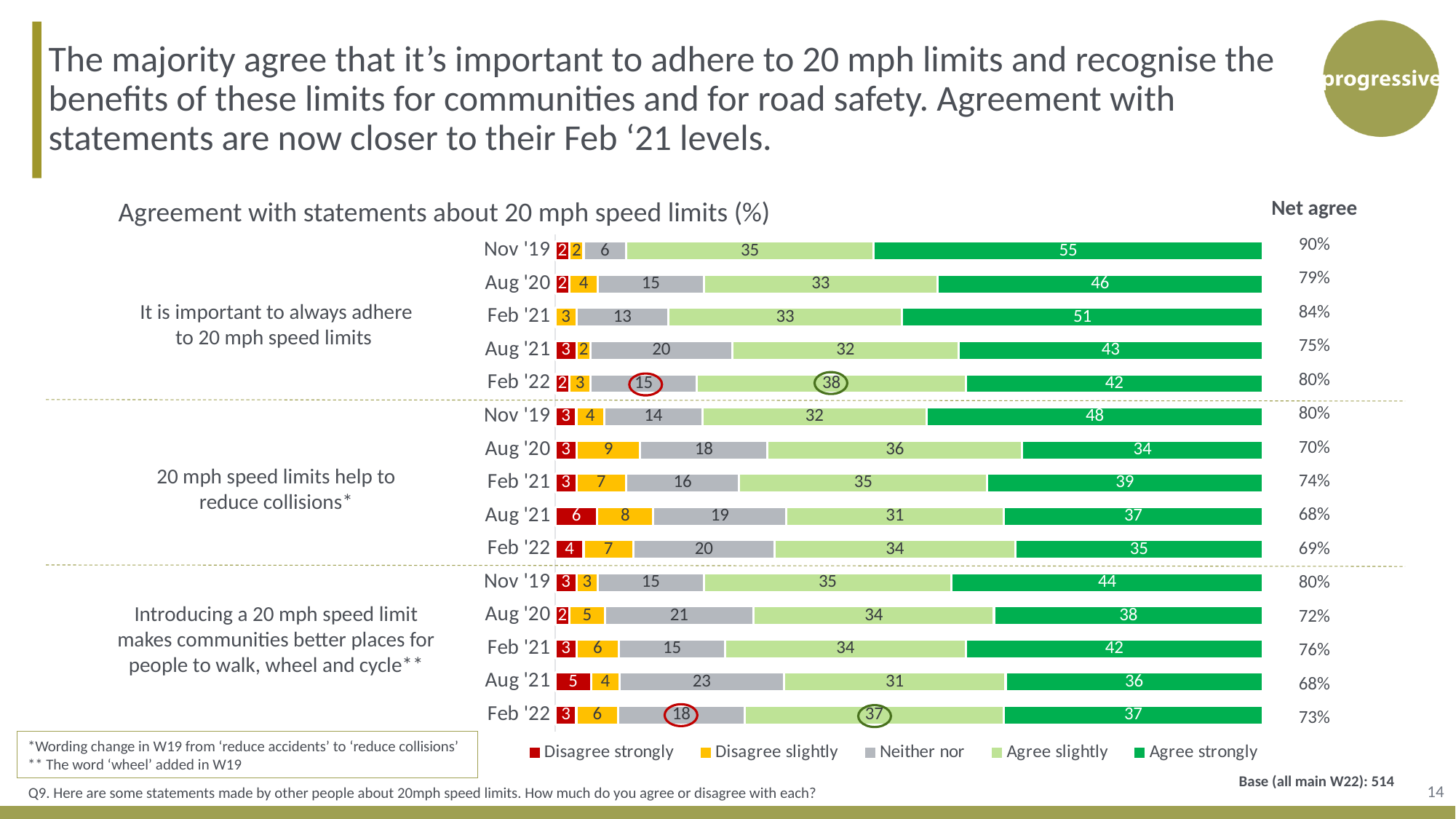
For '20 mph speed limits help to reduce collisions' in Aug '21, what is the combined total of 'Disagree strongly' and 'Disagree slightly'? 14 What is the net agree figure for '20 mph speed limits help to reduce collisions' in Aug '21? 68% Which colour represents 'Disagree strongly' in the legend? Red For 'It is important to always adhere to 20 mph speed limits', how much higher is the 'Agree strongly' value in Nov '19 than in Feb '22? 13 What kind of chart is shown on the slide? Stacked bar chart For '20 mph speed limits help to reduce collisions', which wave has the lowest 'Agree strongly' value? Aug '20 How many survey waves are shown for each statement? 5 How many series does the legend list? 5 For 'Introducing a 20 mph speed limit makes communities better places for people to walk, wheel and cycle', which wave has the highest 'Agree strongly' value? Nov '19 For 'It is important to always adhere to 20 mph speed limits', is the 'Agree slightly' value larger in Feb '22 or Aug '21? Feb '22 For '20 mph speed limits help to reduce collisions', what is the 'Neither nor' value in Feb '22? 20 What percentage agree strongly that it is important to always adhere to 20 mph speed limits in Nov '19? 55